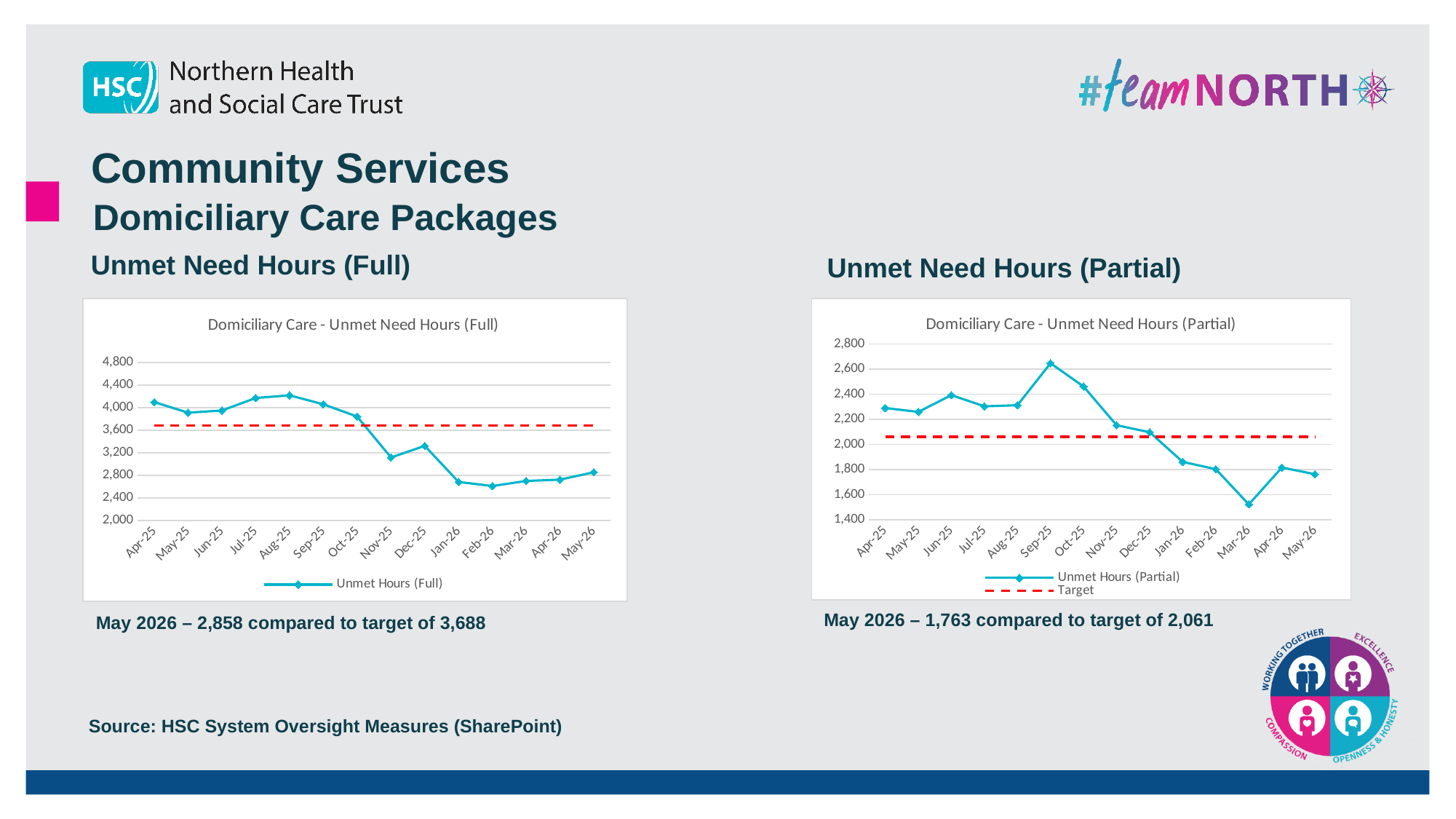
On the Unmet Need Hours (Partial) chart, what is the value for May-26? 1,763 On the Unmet Need Hours (Partial) chart, which month has the lowest value? Mar-26 On the Unmet Need Hours (Partial) chart, how far below the target of 2,061 is the May-26 value? 298 On the Unmet Need Hours (Partial) chart, is the value for Jan-26 greater or less than 2,000? less On the Unmet Need Hours (Full) chart, what is the target value? 3,688 On the Unmet Need Hours (Full) chart, which month has the lowest value? Feb-26 On the Unmet Need Hours (Full) chart, is the value for Apr-25 greater or less than 4,000? greater On the Unmet Need Hours (Full) chart, what is the value for May-26? 2,858 On the Unmet Need Hours (Partial) chart, how many series does the legend list? 2 On the Unmet Need Hours (Full) chart, what kind of chart is shown? line chart On the Unmet Need Hours (Partial) chart, which month has the highest value? Sep-25 On the Unmet Need Hours (Full) chart, how far below the target is the May-26 value? 830